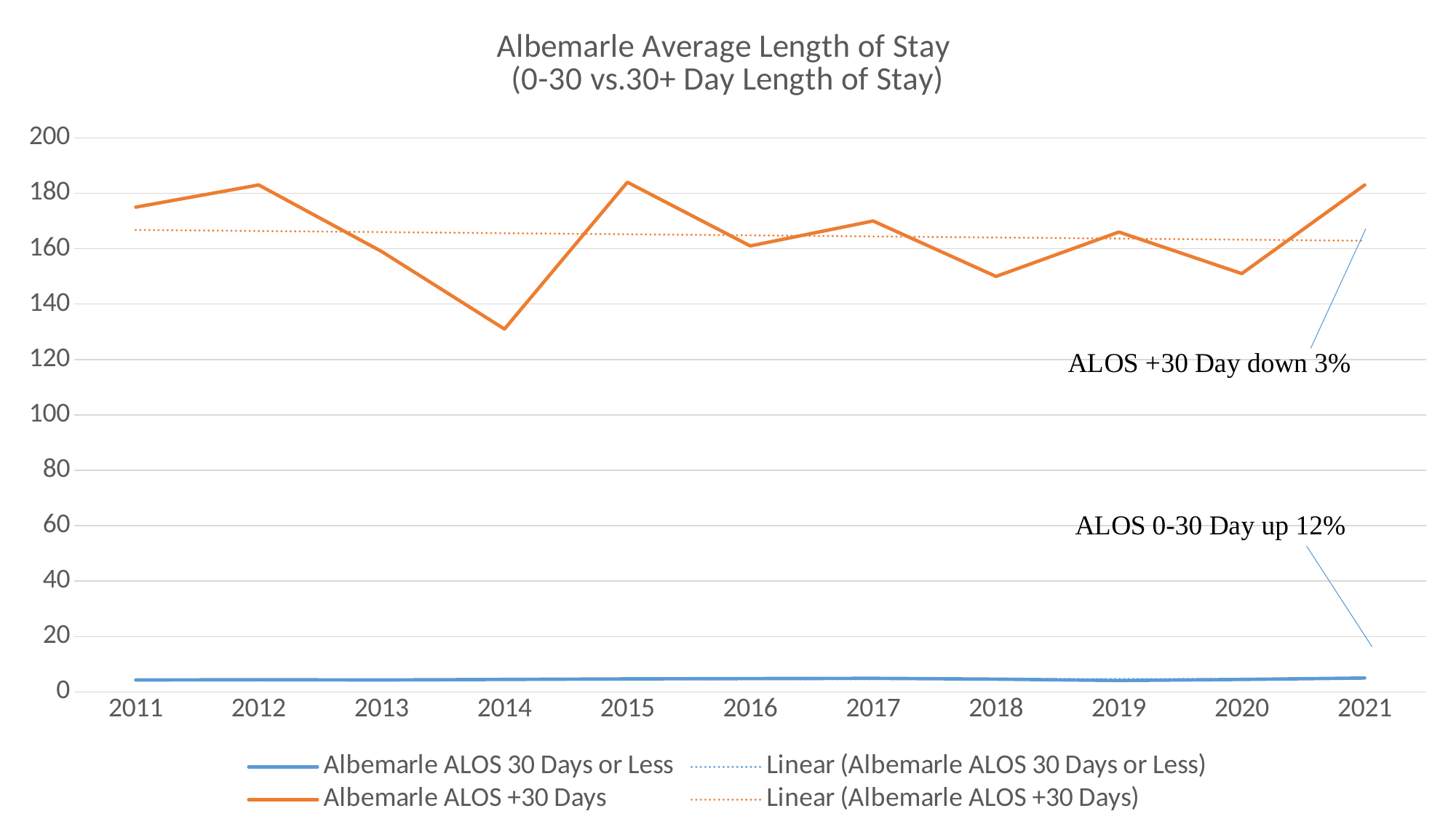
What kind of chart is shown on the slide? line chart Is the Albemarle ALOS +30 Days value for 2011 greater or less than 160? greater According to the annotation on the chart, by what percentage is ALOS 0-30 Day up? 12% How many entries does the legend list? 4 Is the Albemarle ALOS +30 Days value for 2015 greater or less than 180? greater How many years are shown on the x axis? 11 In which year is the Albemarle ALOS +30 Days value lowest? 2014 What is the title of the chart? Albemarle Average Length of Stay (0-30 vs.30+ Day Length of Stay) Which series is higher across all years: Albemarle ALOS 30 Days or Less, or Albemarle ALOS +30 Days? Albemarle ALOS +30 Days Which is larger for Albemarle ALOS +30 Days: the value for 2014 or the value for 2015? 2015 Is the Albemarle ALOS +30 Days value for 2014 greater or less than 140? less